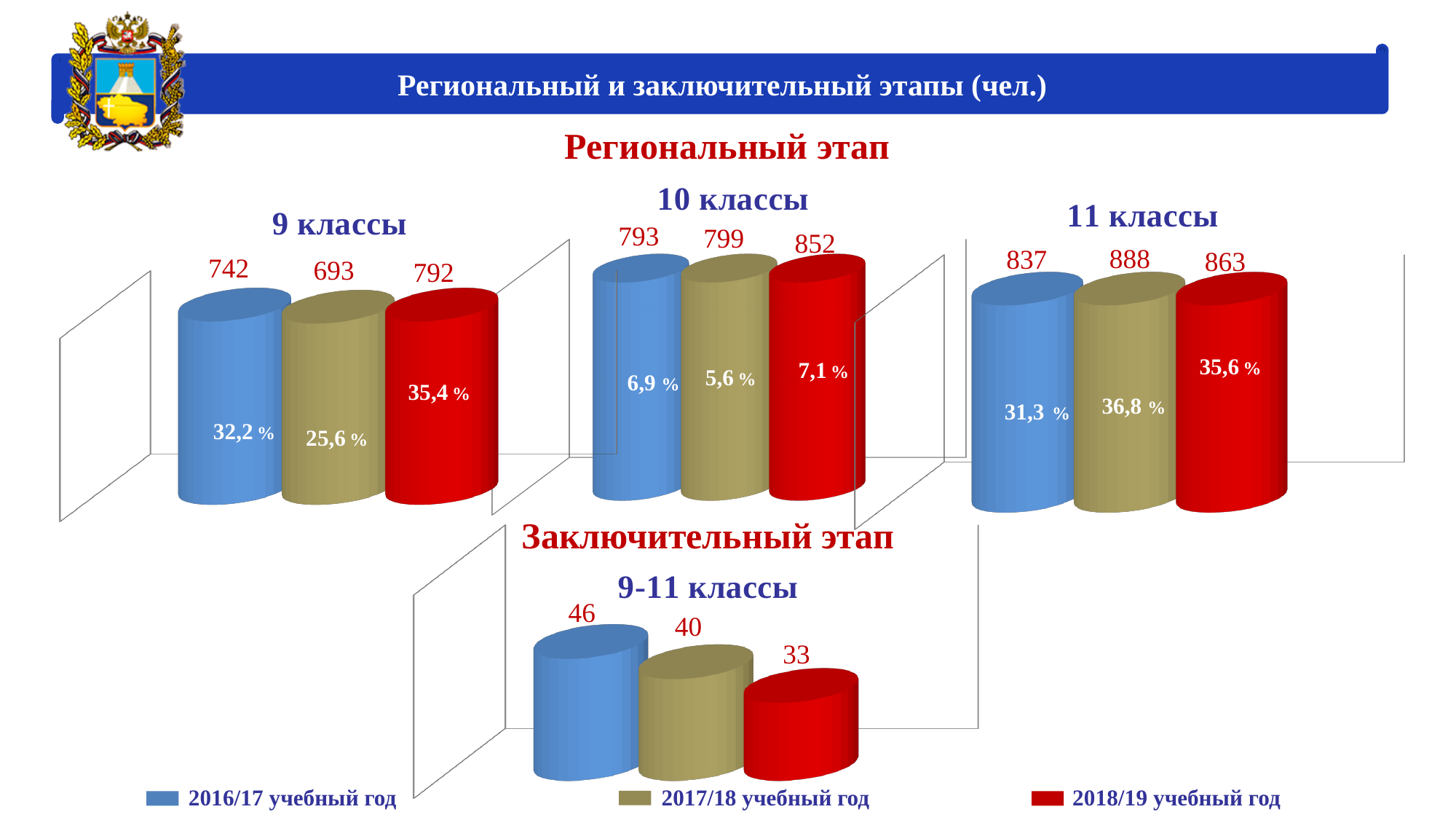
What percentage label is shown on the 2018/19 bar in the "11 классы" chart? 35,6 % In the "11 классы" chart, which school year has the highest value? 2017/18 учебный год In the "9-11 классы" chart, what is the value for 2018/19 учебный год? 33 In the "9 классы" chart, what is the value for 2016/17 учебный год? 742 In the "9-11 классы" chart, what is the difference between the 2016/17 and 2018/19 values? 13 In the "10 классы" chart, what is the difference between the 2018/19 and 2016/17 values? 59 In the "9-11 классы" chart, do the values rise or fall from 2016/17 to 2018/19? fall In the "9 классы" chart, which school year has the lowest value? 2017/18 учебный год In the "10 классы" chart, what is the value for 2018/19 учебный год? 852 In the "9 классы" chart, which is larger: the value for 2016/17 or for 2018/19? 2018/19 In the "11 классы" chart, what is the value for 2017/18 учебный год? 888 How many series does the legend list? 3